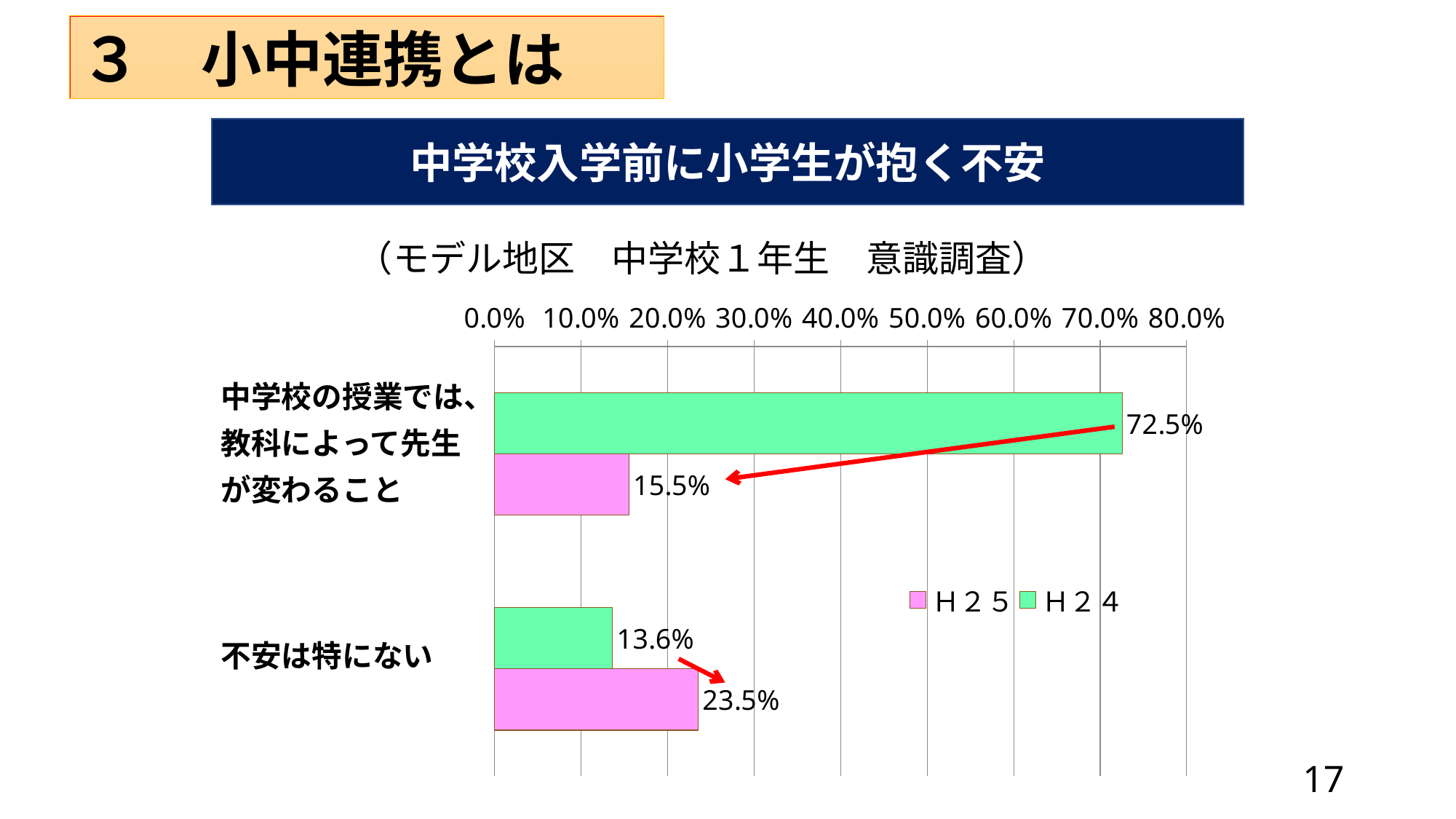
What is the H25 value for 「中学校の授業では、教科によって先生が変わること」? 15.5% What is the H25 value for 「不安は特にない」? 23.5% What kind of chart is shown on the slide? Bar chart How many categories are shown on the chart? 2 Which category has the lowest H25 value? 中学校の授業では、教科によって先生が変わること Which category has the highest H24 value? 中学校の授業では、教科によって先生が変わること Is the H24 value for 「中学校の授業では、教科によって先生が変わること」 greater or less than 70.0%? greater How many series does the legend list? 2 For 「不安は特にない」, which is larger, the H24 value or the H25 value? H25 What is the H24 value for 「不安は特にない」? 13.6% What is the H24 value for 「中学校の授業では、教科によって先生が変わること」? 72.5% What is the difference between the H24 and H25 values for 「中学校の授業では、教科によって先生が変わること」? 57.0%